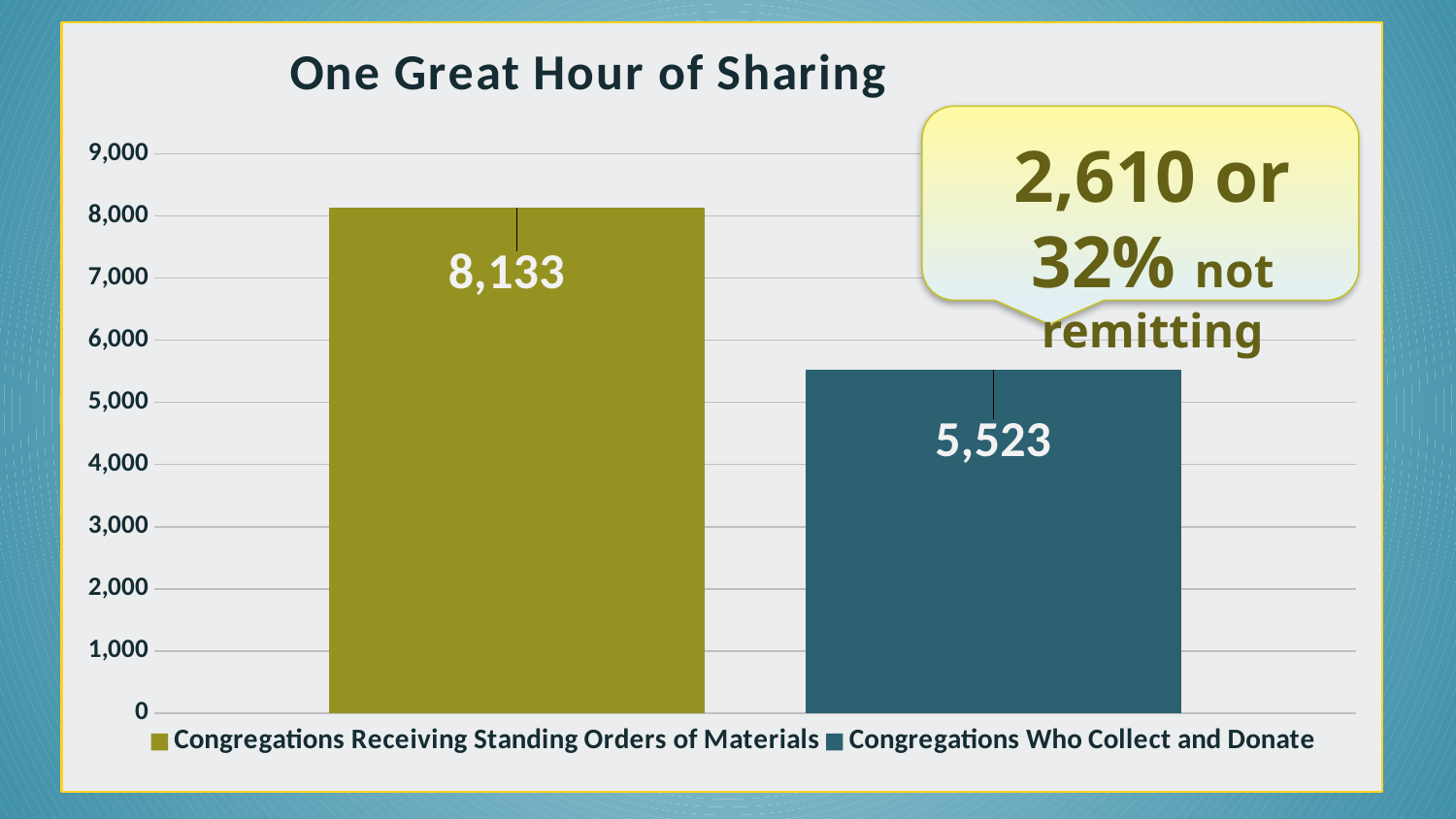
What is the title of the chart? One Great Hour of Sharing How many bars are plotted on the chart? 2 What kind of chart is shown? bar chart Is the value for Congregations Receiving Standing Orders of Materials greater or less than 8,000? greater Which series has the higher value? Congregations Receiving Standing Orders of Materials Is the value for Congregations Who Collect and Donate greater or less than 6,000? less Which series has the lower value? Congregations Who Collect and Donate How many series does the legend list? 2 What is the value for Congregations Who Collect and Donate? 5,523 What is the difference between Congregations Receiving Standing Orders of Materials and Congregations Who Collect and Donate? 2,610 What is the value for Congregations Receiving Standing Orders of Materials? 8,133 Is the value for Congregations Receiving Standing Orders of Materials larger or smaller than the value for Congregations Who Collect and Donate? larger